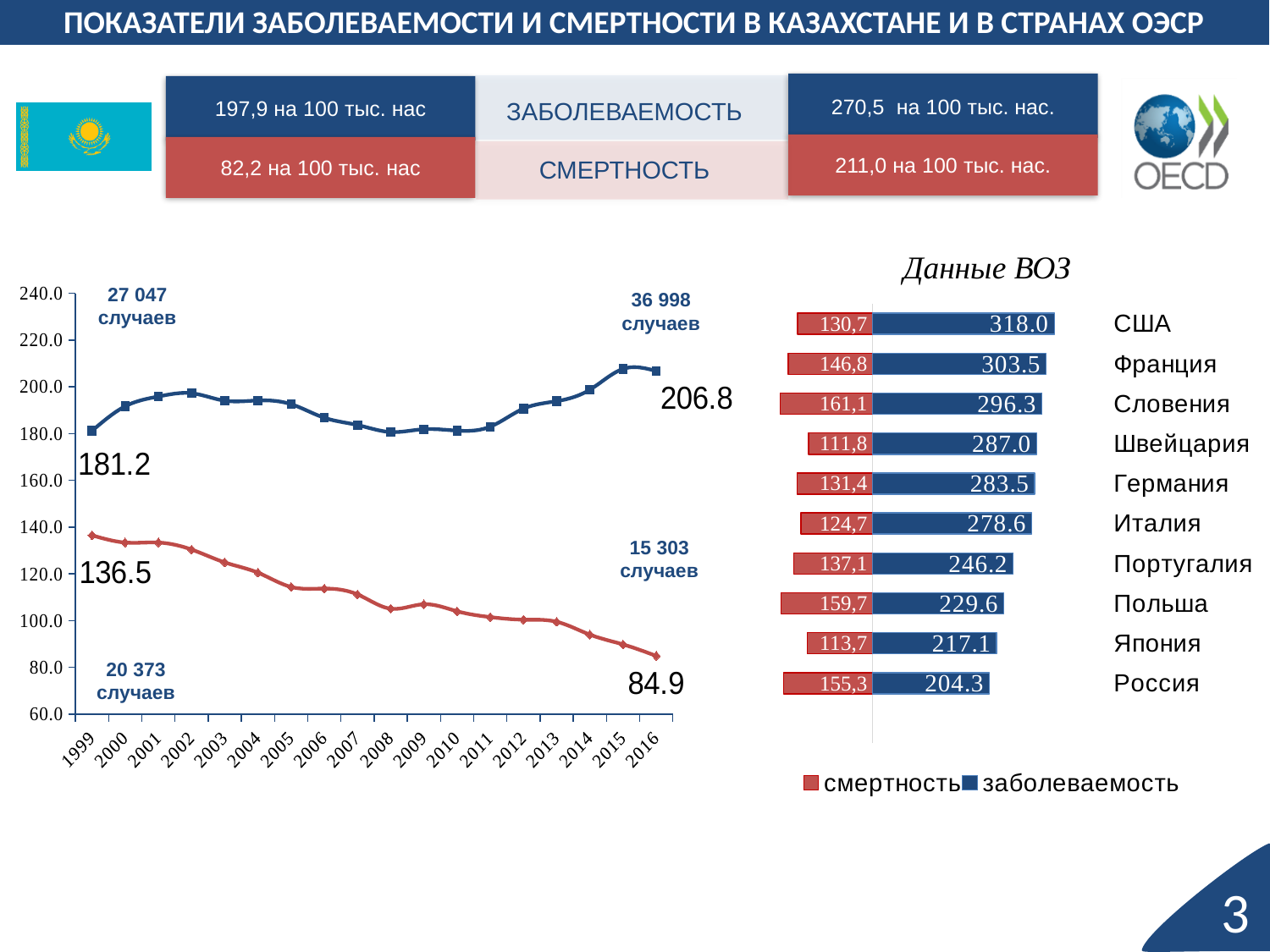
In the 'Данные ВОЗ' bar chart, what is the заболеваемость value for Франция? 303.5 In the 'Данные ВОЗ' bar chart, which country has the lowest смертность value? Швейцария In the 'Данные ВОЗ' bar chart, which country has the highest заболеваемость value? США In the line chart on the left, is the blue line's value in 2008 greater or less than 200.0? less In the line chart on the left, what is the value of the red (lower) line in 1999? 136.5 In the 'Данные ВОЗ' bar chart, which is larger: the смертность value for Польша or for Япония? Польша In the line chart on the left, how many years are shown on the x axis? 18 In the line chart on the left, what is the value of the blue (upper) line in 2016? 206.8 In the line chart on the left, what is the difference between the blue line's 2016 value (206.8) and its 1999 value (181.2)? 25.6 What type of chart is the 'Данные ВОЗ' chart on the right? bar chart In the 'Данные ВОЗ' bar chart, what is the смертность value for Россия? 155,3 In the line chart on the left, does the red (lower) line rise or fall from 1999 to 2016? fall